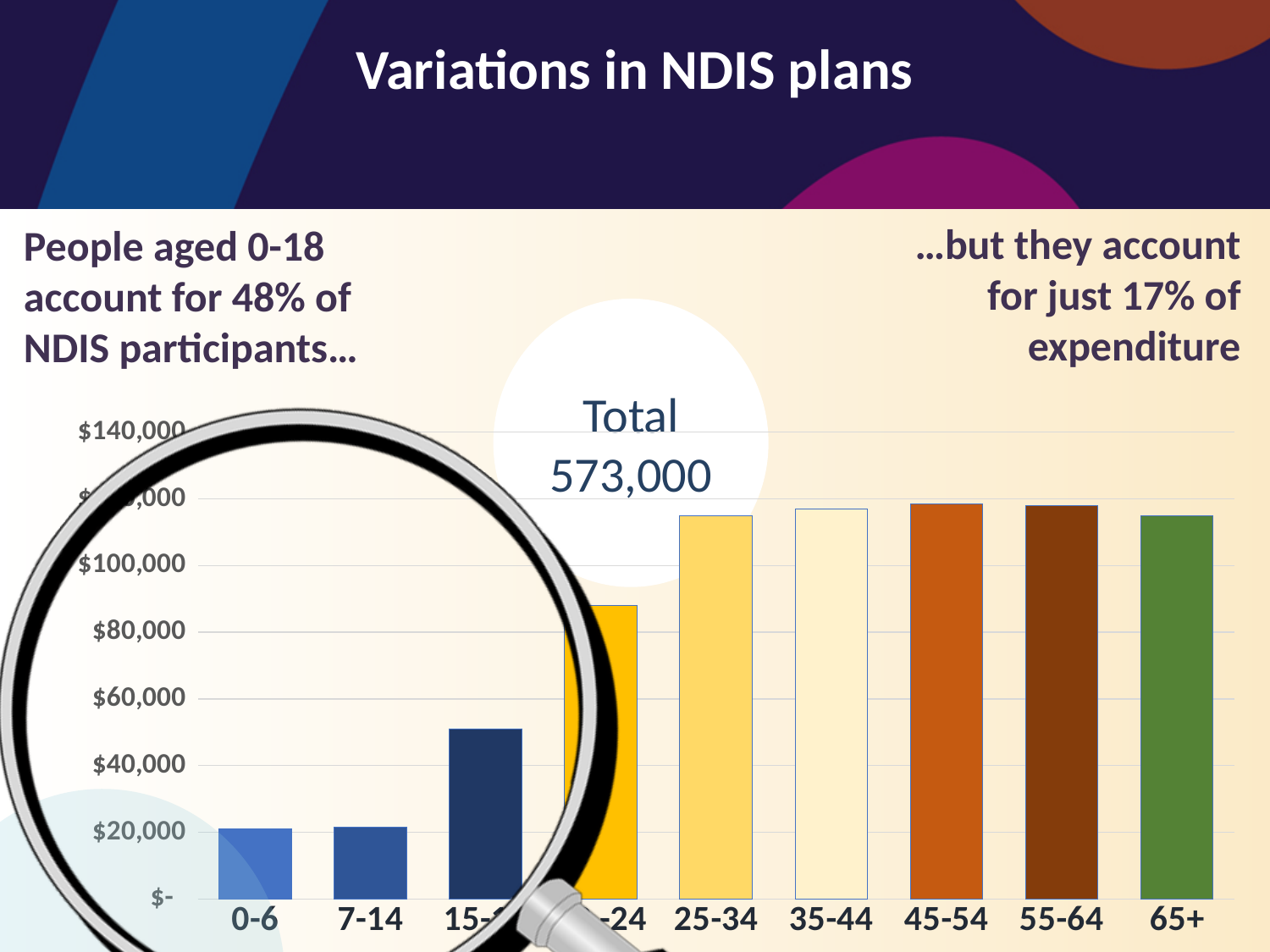
Is the value for the 25-34 age group greater or less than $100,000? greater Do the values generally rise or fall from the 0-6 age group to the 25-34 age group? rise What total figure is shown in the circle above the chart? 573,000 Is the value for the 0-6 age group greater or less than $40,000? less Is the value for the 45-54 age group greater or less than $100,000? greater How many age-group bars are plotted in the chart? 9 What is the title of the slide containing the chart? Variations in NDIS plans Which has the larger value, the 7-14 age group or the 65+ age group? 65+ What kind of chart is shown on the slide? bar chart Which has the larger value, the 0-6 age group or the 25-34 age group? 25-34